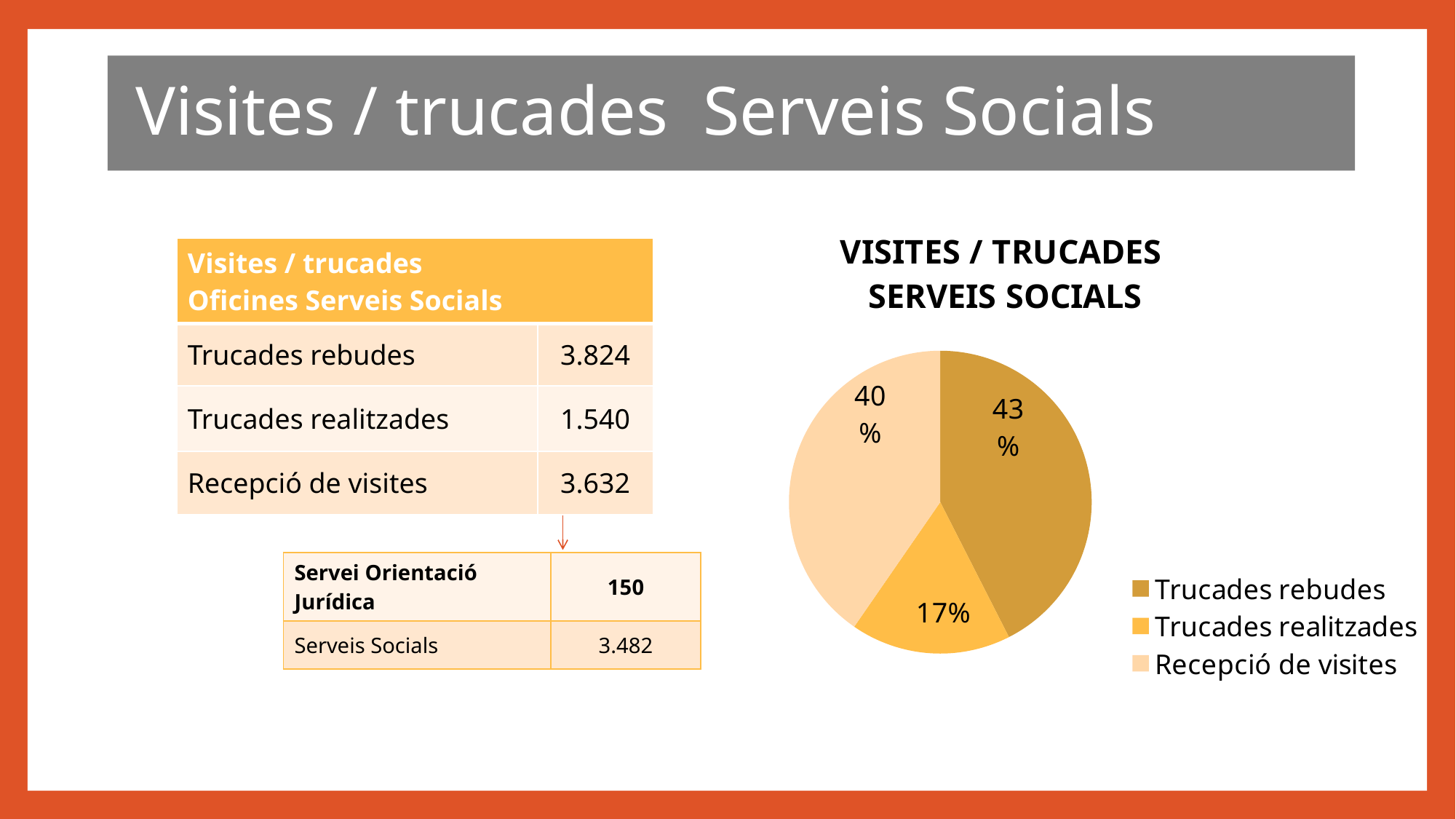
Which slice is larger in the pie chart, Trucades rebudes or Recepció de visites? Trucades rebudes What share of the pie chart is Trucades realitzades? 17% Which category has the largest slice in the pie chart? Trucades rebudes What is the title of the pie chart? VISITES / TRUCADES SERVEIS SOCIALS How many slices does the pie chart have? 3 Which legend entry is shown in the lightest colour in the pie chart? Recepció de visites Which category has the smallest slice in the pie chart? Trucades realitzades What type of chart is shown on the slide? Pie chart What is the difference in percentage points between the Trucades rebudes slice and the Trucades realitzades slice? 26 What share of the pie chart is Trucades rebudes? 43% How many entries does the legend of the pie chart list? 3 What share of the pie chart is Recepció de visites? 40%